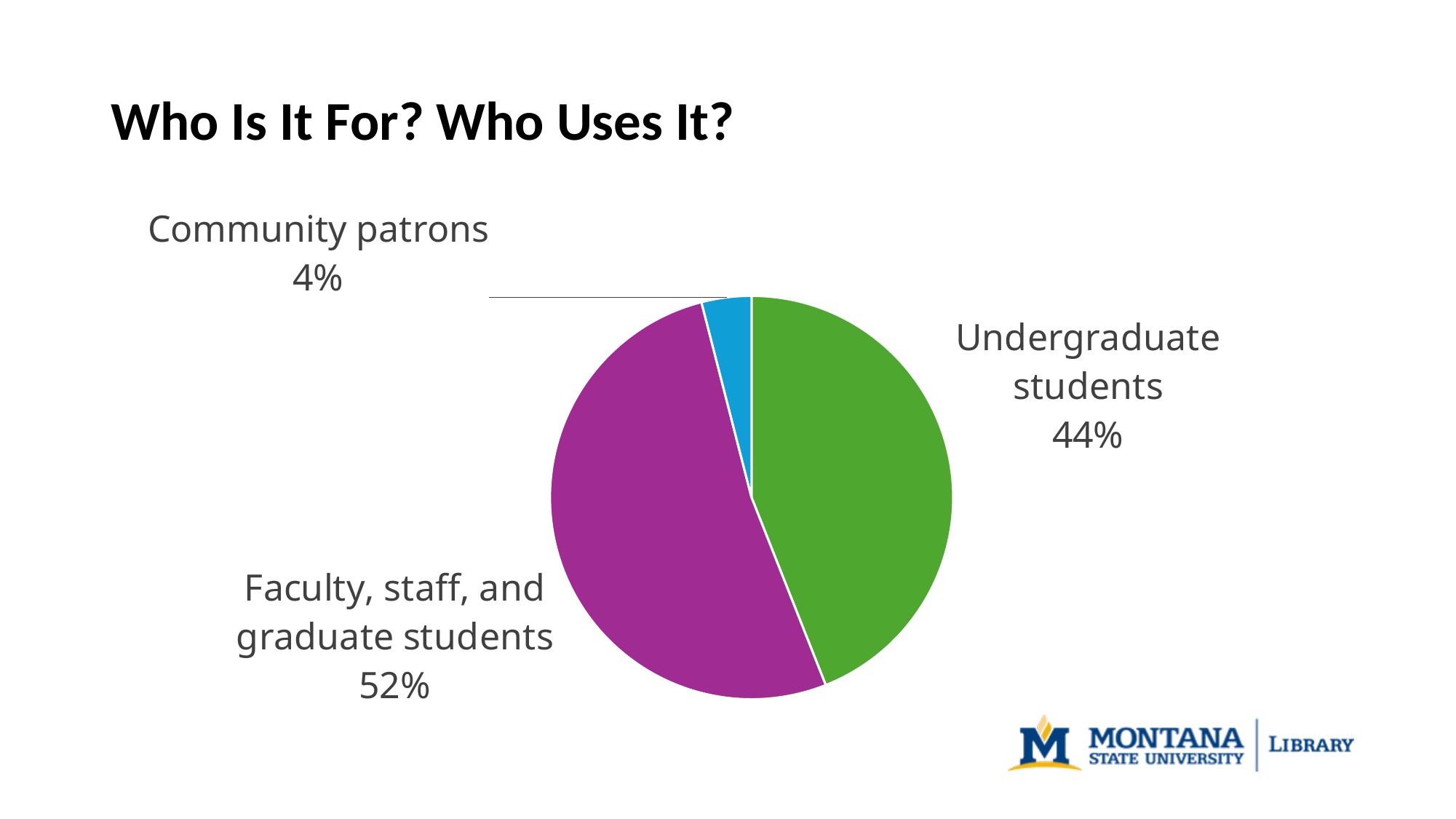
What is the title of the slide containing the pie chart? Who Is It For? Who Uses It? How many slices does the pie chart have? 3 Which category has the largest slice of the pie? Faculty, staff, and graduate students What is the difference in percentage points between Undergraduate students and Community patrons? 40 What share of the pie is Undergraduate students? 44% What share of the pie is Community patrons? 4% Which is larger: the share for Undergraduate students or the share for Community patrons? Undergraduate students What kind of chart is shown on the slide? Pie chart Which category has the smallest slice of the pie? Community patrons What colour is the slice for Undergraduate students? Green What is the difference in percentage points between Faculty, staff, and graduate students and Undergraduate students? 8 What share of the pie is Faculty, staff, and graduate students? 52%